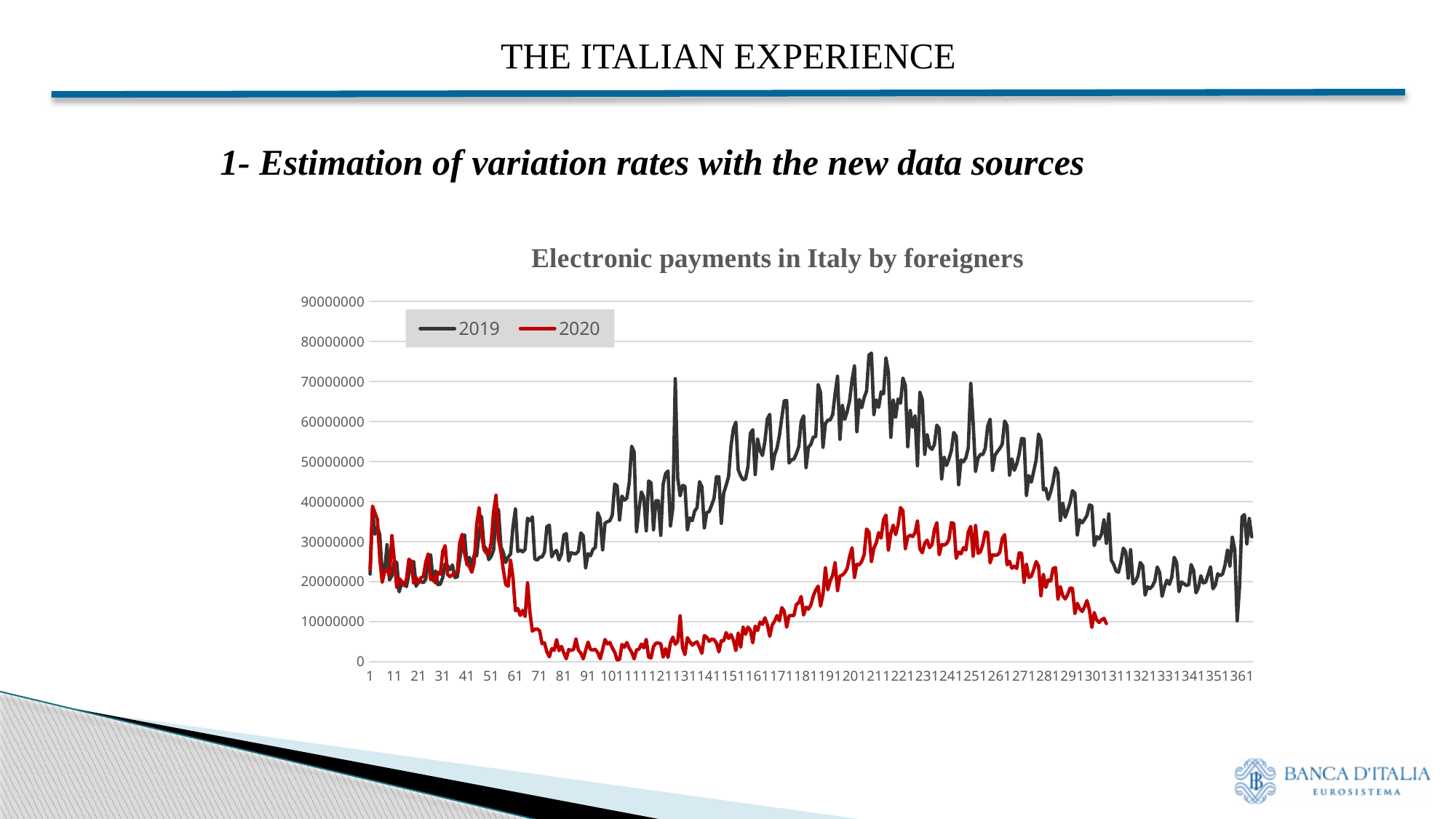
How many series does the legend of the chart list? 2 Is the peak value of the 2019 series greater or less than 70000000? greater What kind of chart is shown on the slide? line chart Is the peak value of the 2020 series greater or less than 50000000? less Does the 2019 series rise or fall between x = 101 and x = 201? rise Which colour is used for the 2020 series in the chart? red Which series reaches the higher peak value, 2019 or 2020? 2019 Is the value of the 2020 series around x = 91 greater or less than 10000000? less Does the 2020 series rise or fall between x = 221 and x = 301? fall Around x = 201, which series has the higher value, 2019 or 2020? 2019 What is the title of the chart? Electronic payments in Italy by foreigners